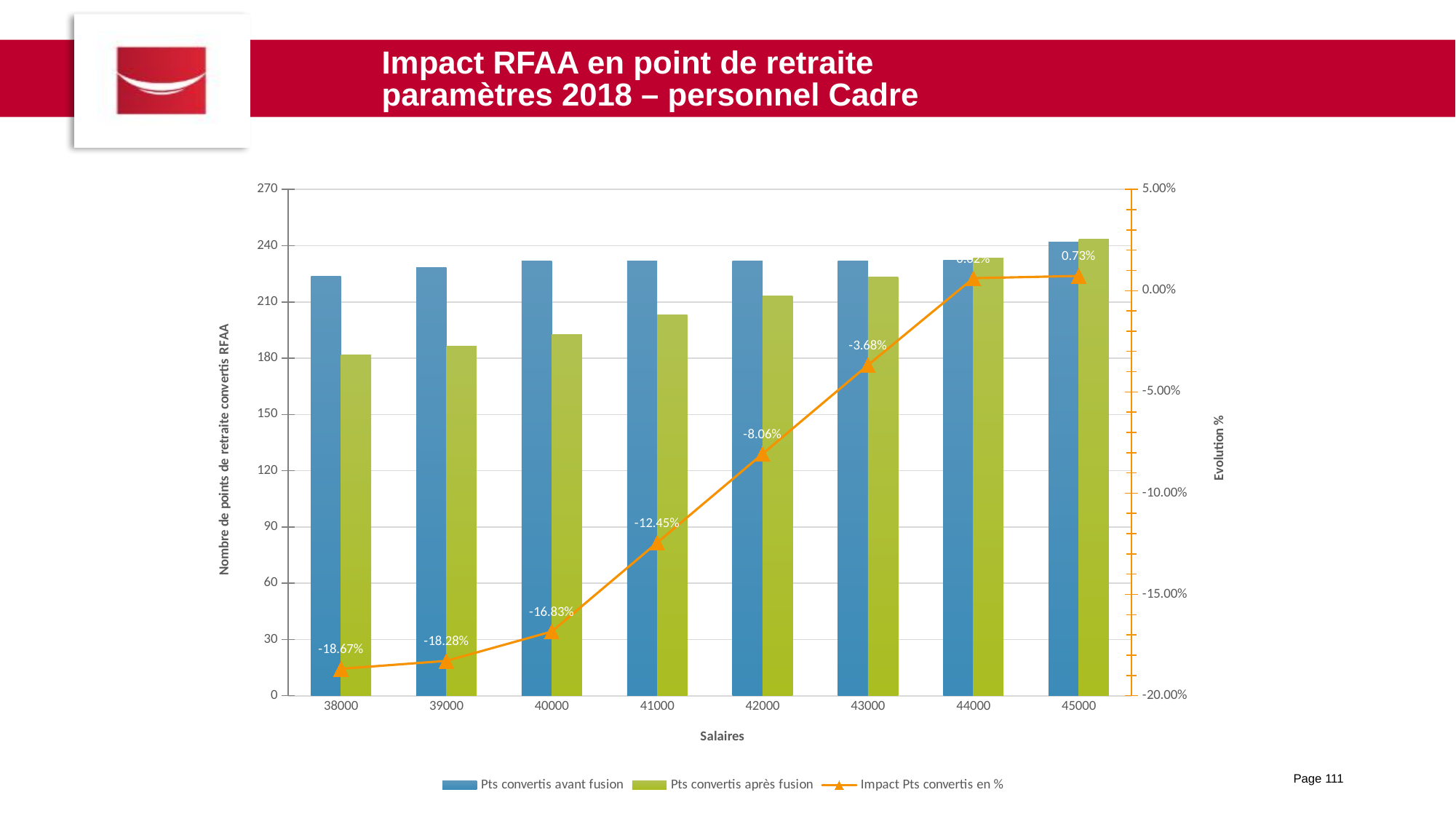
What is the value of Impact Pts convertis en % for the salary 38000? -18.67% What is the difference in percentage points between the Impact Pts convertis en % at 39000 and at 38000? 0.39 What is the value of Impact Pts convertis en % for the salary 45000? 0.73% Does the Impact Pts convertis en % line rise or fall as salary increases? rise What is the value of Impact Pts convertis en % for the salary 43000? -3.68% How many salary categories are shown on the x axis? 8 How many series does the legend list? 3 Is the value of Pts convertis après fusion at salary 41000 greater or less than 210? less Is the value of Pts convertis avant fusion at salary 38000 greater or less than 210? greater For which salary is the Impact Pts convertis en % lowest? 38000 Which is larger at salary 38000: Pts convertis avant fusion or Pts convertis après fusion? Pts convertis avant fusion What is the value of Impact Pts convertis en % for the salary 41000? -12.45%